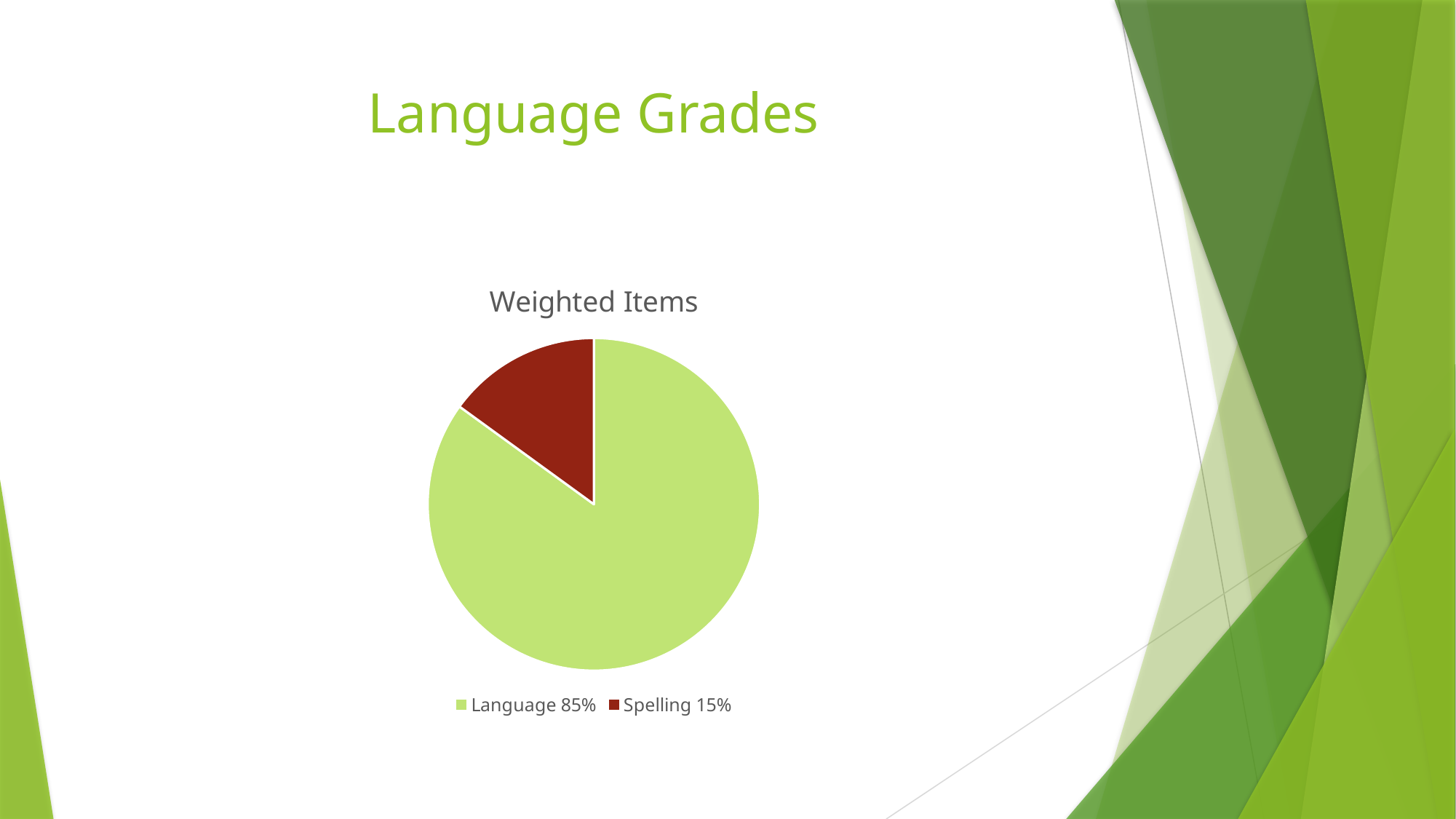
What is the difference in percentage points between the Language and Spelling slices? 70 Which slice is the smallest in the pie chart? Spelling What is the total of the two slices shown in the legend? 100% Which is larger, the Language slice or the Spelling slice? Language What share of the pie does Spelling represent? 15% What share of the pie does Language represent? 85% What colour is the Spelling slice? dark red What kind of chart is shown on the slide? pie chart What is the title of the chart? Weighted Items Which slice is the largest in the pie chart? Language How many slices does the pie chart have? 2